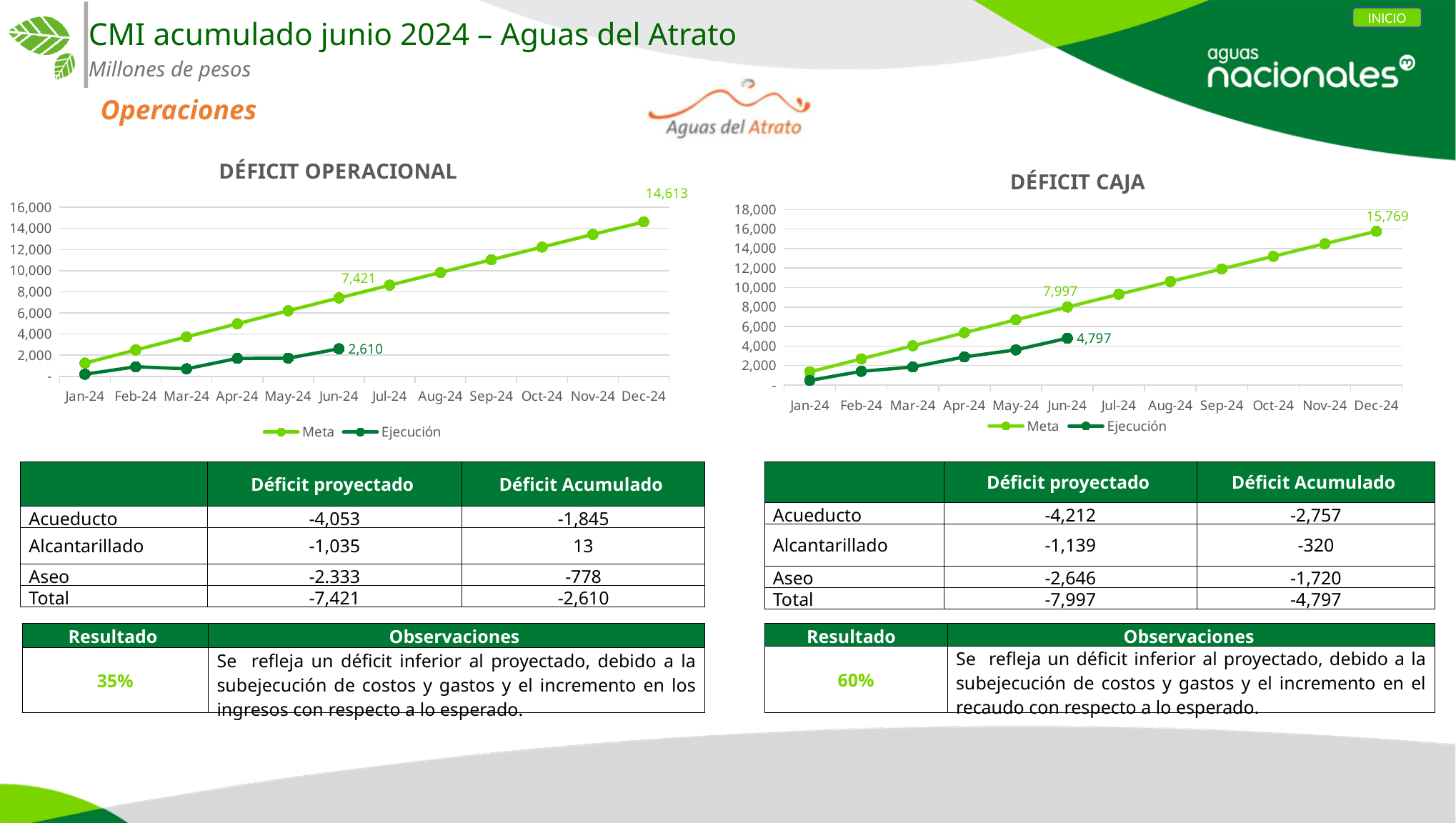
In the DÉFICIT OPERACIONAL chart, is the Meta value for Sep-24 greater or less than 10,000? greater What kind of chart is the DÉFICIT OPERACIONAL chart? Line chart In the DÉFICIT OPERACIONAL chart, what is the Ejecución value for Jun-24? 2,610 In the DÉFICIT CAJA chart, what is the Meta value for Jun-24? 7,997 In the DÉFICIT CAJA chart, is the Ejecución value for Mar-24 greater or less than 4,000? less In the DÉFICIT OPERACIONAL chart, what is the Meta value for Dec-24? 14,613 In the DÉFICIT CAJA chart, which series has the larger value at Jun-24, Meta or Ejecución? Meta How many months are shown on the x axis of the DÉFICIT OPERACIONAL chart? 12 In the DÉFICIT CAJA chart, what is the difference between the Meta value for Dec-24 and the Meta value for Jun-24? 7,772 In the DÉFICIT CAJA chart, what is the Ejecución value for Jun-24? 4,797 How many series does the legend of the DÉFICIT CAJA chart list? 2 In the DÉFICIT OPERACIONAL chart, what is the difference between the Meta and Ejecución values for Jun-24? 4,811